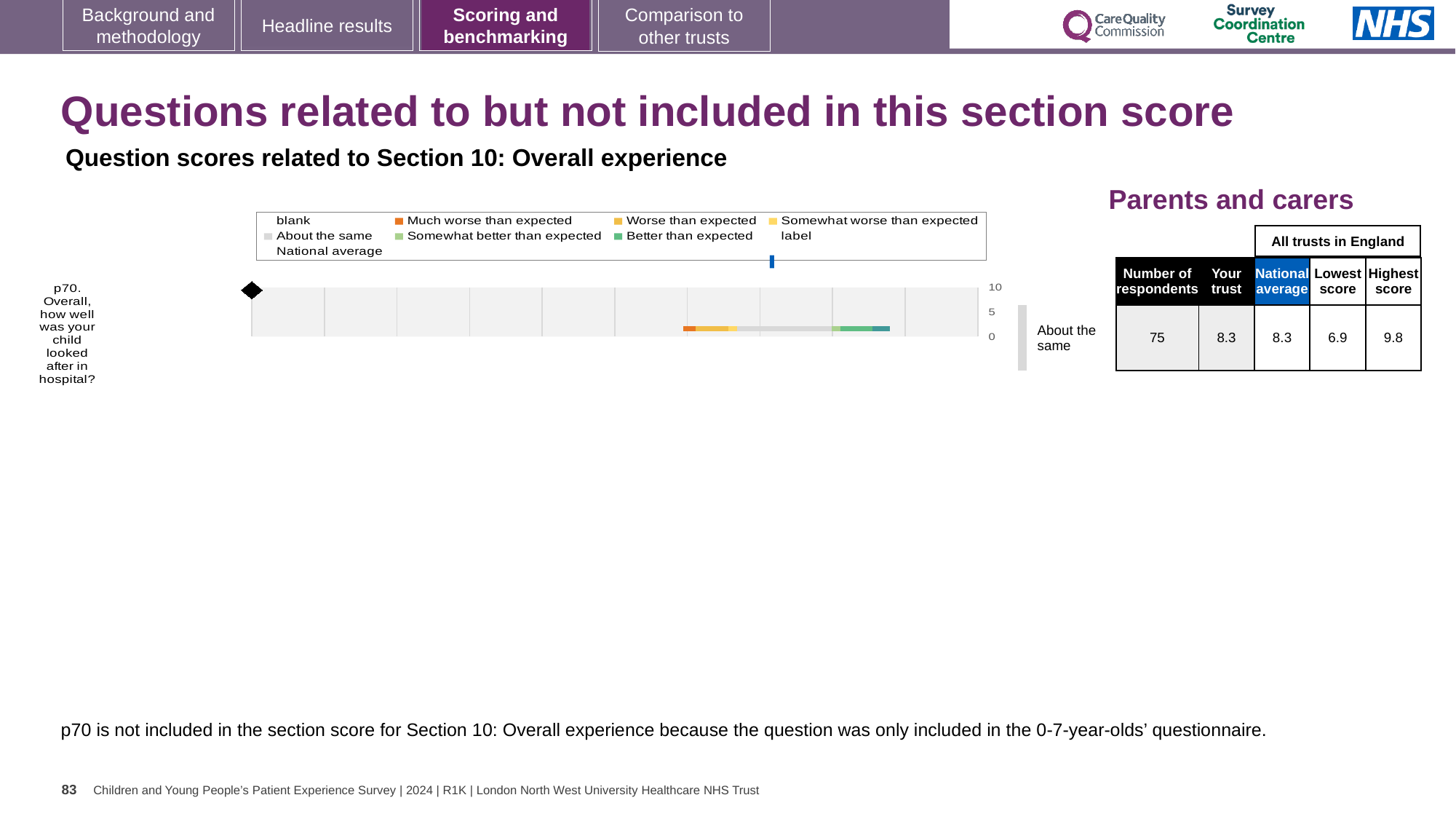
According to the table, what is the lowest score among all trusts in England for p70? 6.9 Which is larger for p70: the highest score or the 'Your trust' score? Highest score What is the difference between the highest score and the lowest score for p70 in the table? 2.9 How many survey questions are plotted in the chart? 1 Which legend entry is shown in orange? Much worse than expected According to the table, what is the national average score for p70? 8.3 How many respondents answered p70 according to the table? 75 What kind of chart is shown for question p70? bar chart According to the table, what is the 'Your trust' score for p70? 8.3 Which benchmark category is the trust's result for p70 labelled as next to the chart? About the same Which question is plotted in the chart? p70. Overall, how well was your child looked after in hospital? According to the table, what is the highest score among all trusts in England for p70? 9.8